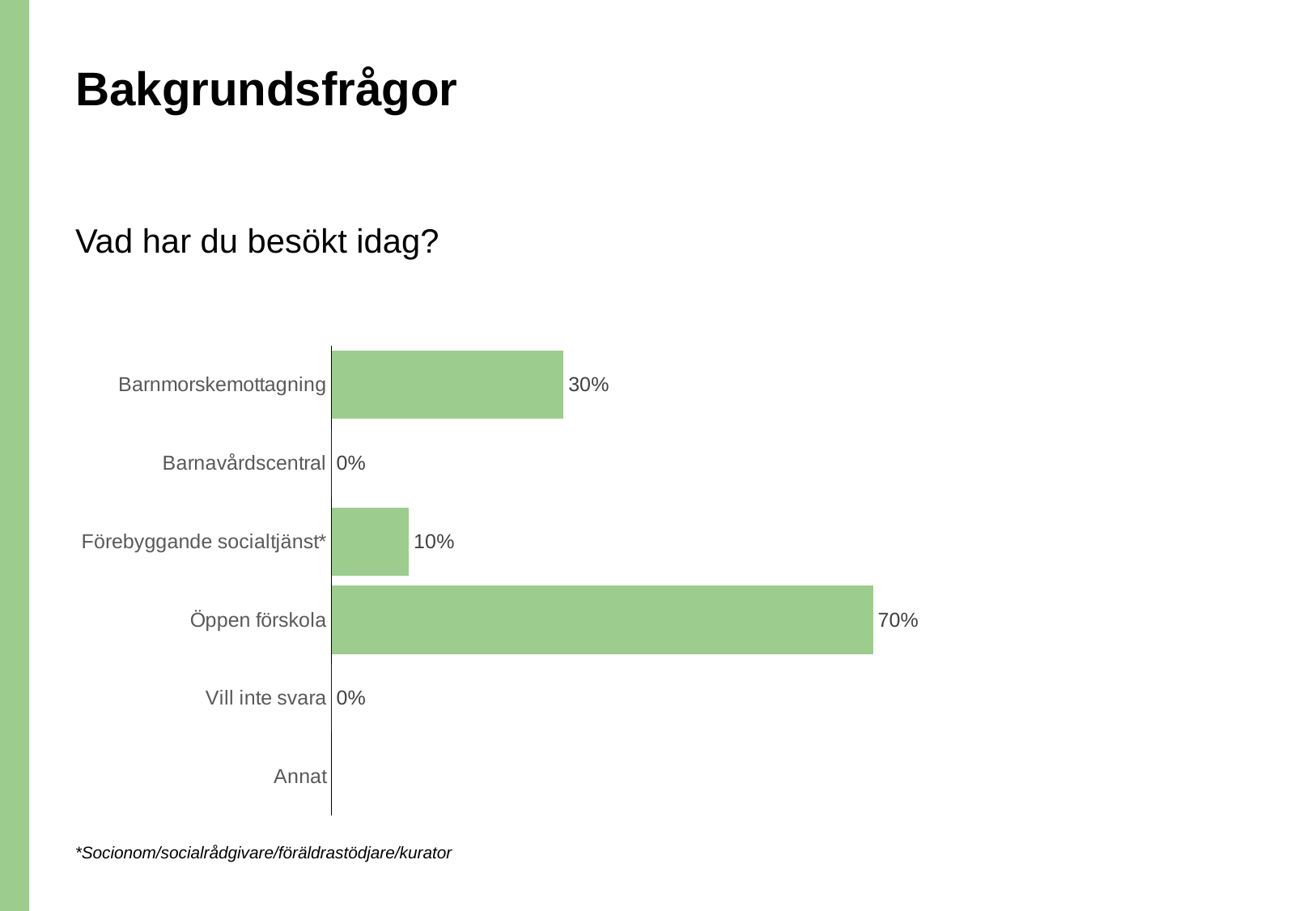
What is the difference between the values for Barnmorskemottagning and Förebyggande socialtjänst*? 20% What is the value for Vill inte svara? 0% Which category has the highest value? Öppen förskola Which is larger, the value for Barnmorskemottagning or the value for Förebyggande socialtjänst*? Barnmorskemottagning What is the difference between the values for Öppen förskola and Barnmorskemottagning? 40% What is the value for Barnmorskemottagning? 30% How many categories are shown on the chart? 6 What question does the chart answer, according to the text above it? Vad har du besökt idag? What is the value for Öppen förskola? 70% What is the value for Förebyggande socialtjänst*? 10% What is the value for Barnavårdscentral? 0% What kind of chart is shown on the slide? Bar chart